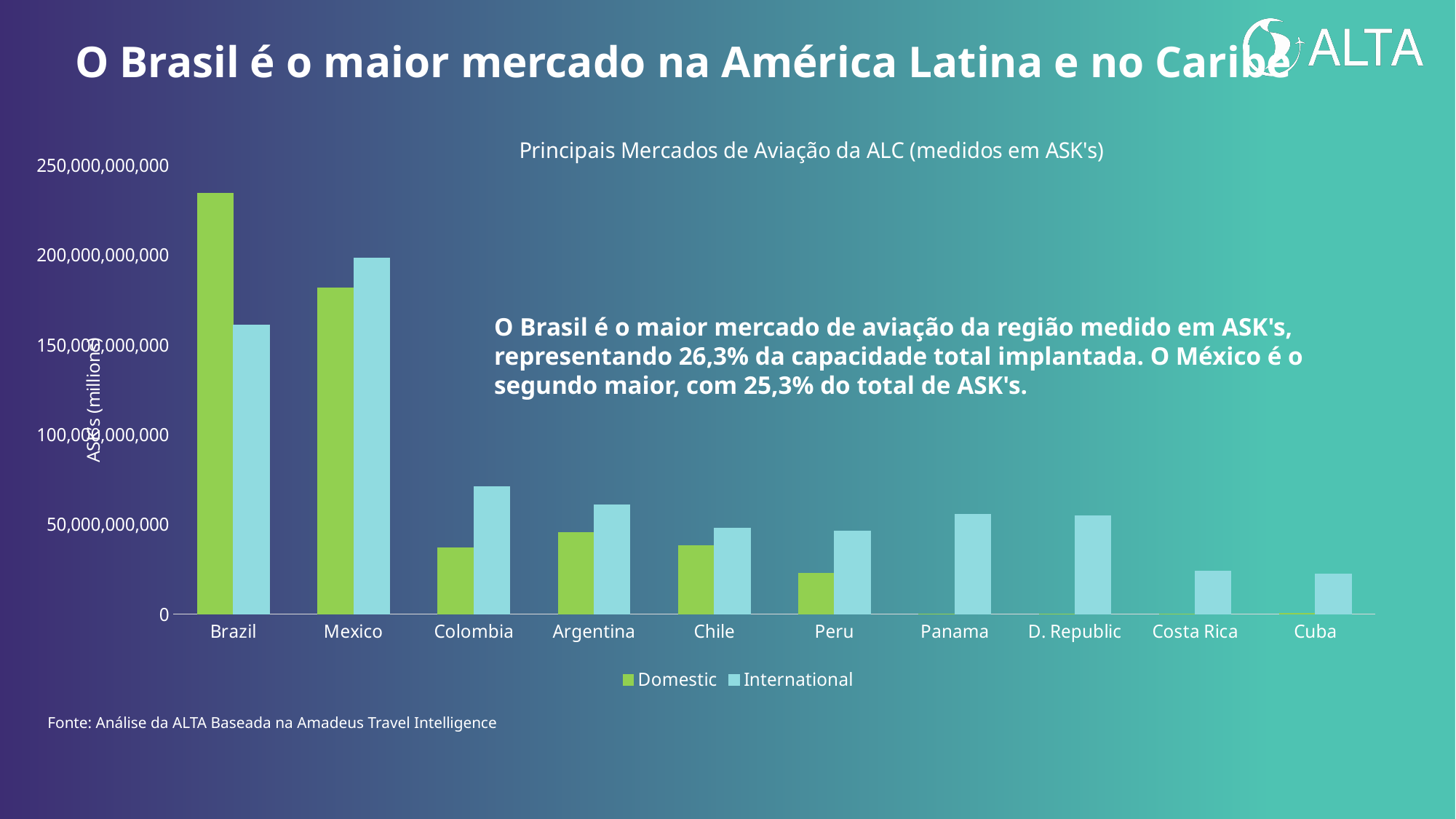
How many series does the legend list? 2 Is the International value for Colombia greater or less than 50,000,000,000? greater How many countries are shown on the x axis? 10 Which is larger, the Domestic value for Brazil or the Domestic value for Mexico? Brazil What kind of chart is shown on the slide? bar chart Which country has the highest Domestic value? Brazil For Mexico, which is larger, the Domestic or the International value? International What is the title of the chart? Principais Mercados de Aviação da ALC (medidos em ASK's) Which country has the highest International value? Mexico Is the Domestic value for Brazil greater or less than 200,000,000,000? greater Which colour represents the Domestic series in the legend? green Is the Domestic value for Peru greater or less than 50,000,000,000? less